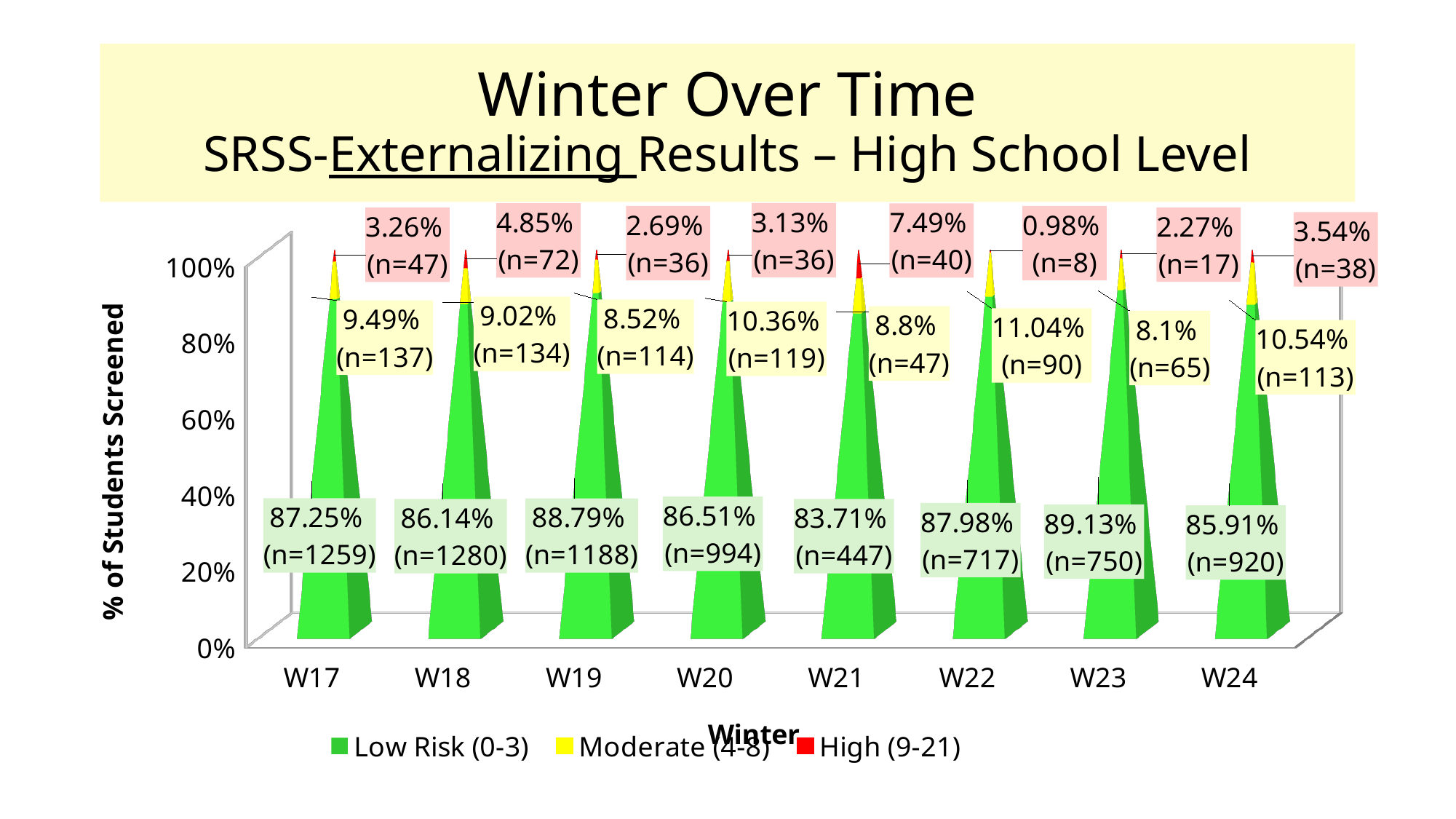
What is the Moderate (4-8) percentage for W22? 11.04% How many winters are shown on the x axis? 8 What is the High (9-21) percentage for W21? 7.49% How many students were in the Low Risk (0-3) group for W18? n=1280 Which is larger, the Moderate (4-8) percentage for W20 or for W23? W20 How many series does the legend list? 3 What kind of chart is shown on the slide? Stacked bar chart What is the Low Risk (0-3) percentage for W19? 88.79% What is the difference between the High (9-21) percentages for W21 and W22? 6.51 percentage points Which winter has the highest Low Risk (0-3) percentage? W23 Which winter has the lowest High (9-21) percentage? W22 Which winter has the highest High (9-21) percentage? W21